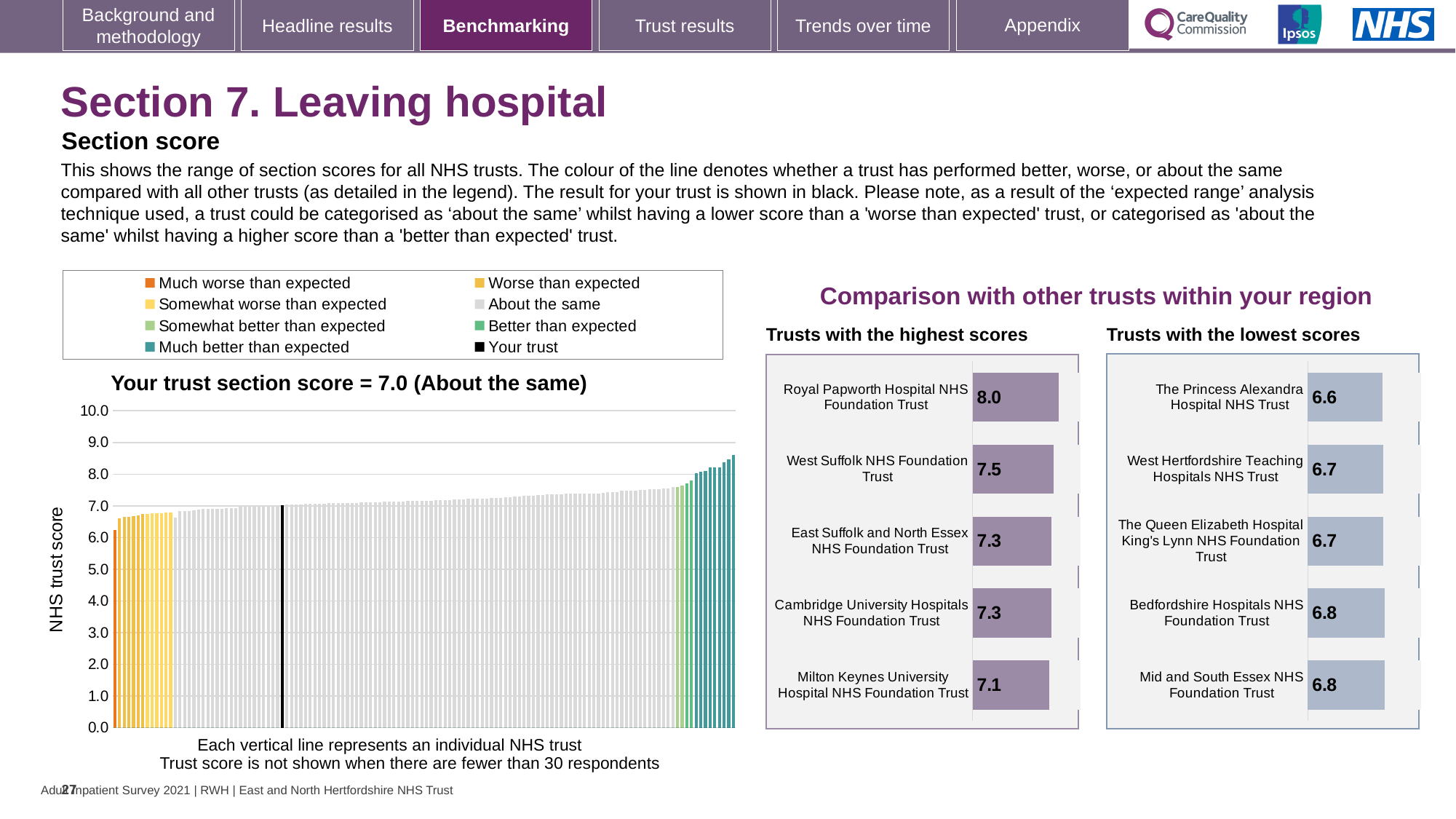
On the main 'Your trust section score' chart, what is the section score for your trust? 7.0 On the main 'Your trust section score' chart, is the value of the tallest bar greater or less than 8.0? greater On the 'Trusts with the lowest scores' chart, what is the score for The Princess Alexandra Hospital NHS Trust? 6.6 On the 'Trusts with the lowest scores' chart, which trust has the lowest score? The Princess Alexandra Hospital NHS Trust How many entries does the legend of the main 'Your trust section score' chart list? 8 On the 'Trusts with the lowest scores' chart, what is the difference between the scores of Mid and South Essex NHS Foundation Trust and The Princess Alexandra Hospital NHS Trust? 0.2 On the 'Trusts with the highest scores' chart, which trust has the lowest score shown? Milton Keynes University Hospital NHS Foundation Trust On the main 'Your trust section score' chart, do the bar values rise or fall from left to right along the x axis? rise On the 'Trusts with the highest scores' chart, what is the score for Royal Papworth Hospital NHS Foundation Trust? 8.0 On the 'Trusts with the highest scores' chart, what is the difference between the scores of Royal Papworth Hospital NHS Foundation Trust and Milton Keynes University Hospital NHS Foundation Trust? 0.9 How many trusts are listed on the 'Trusts with the lowest scores' chart? 5 On the 'Trusts with the highest scores' chart, which has the higher score: Royal Papworth Hospital NHS Foundation Trust or West Suffolk NHS Foundation Trust? Royal Papworth Hospital NHS Foundation Trust